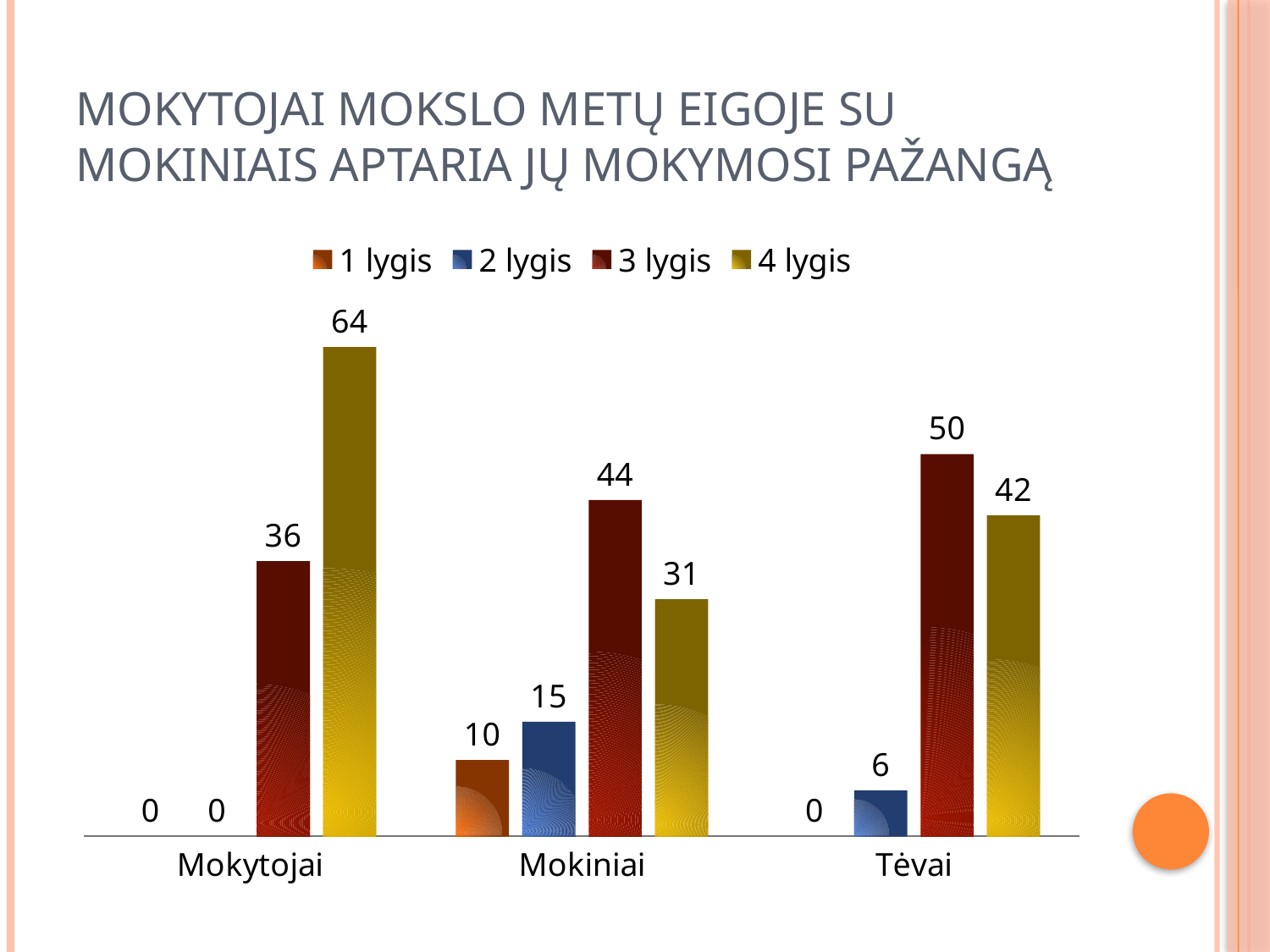
What is the total of the four series values for Mokiniai? 100 What is the value for 2 lygis in the Mokiniai category? 15 Which is larger for Tėvai: the 3 lygis value or the 4 lygis value? 3 lygis What kind of chart is shown on the slide? Bar chart What is the difference between the 4 lygis and 3 lygis values for Mokytojai? 28 How many categories are shown on the x axis? 3 Which category has the highest value for 4 lygis? Mokytojai What is the value for 4 lygis in the Mokytojai category? 64 What is the value for 1 lygis in the Tėvai category? 0 How many series does the legend list? 4 Which category has the lowest value for 3 lygis? Mokytojai What is the value for 3 lygis in the Tėvai category? 50